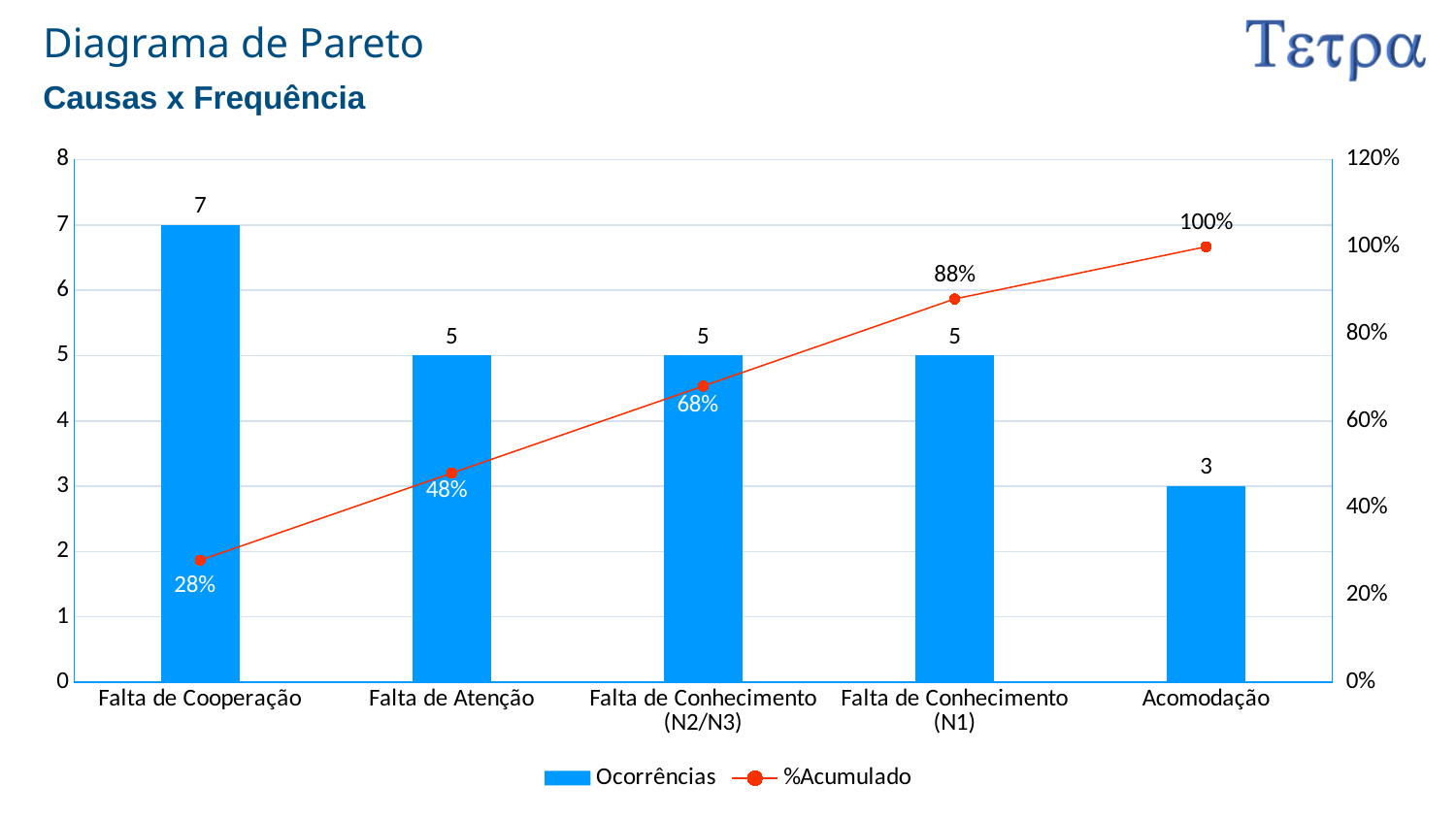
Which category has the lowest number of occurrences? Acomodação Which category has the highest number of occurrences? Falta de Cooperação How many categories are shown on the x axis? 5 How many occurrences (Ocorrências) are shown for Falta de Cooperação? 7 How many series does the legend list? 2 What is the %Acumulado value at Falta de Atenção? 48% What is the difference in occurrences between Falta de Cooperação and Acomodação? 4 Which has more occurrences, Falta de Atenção or Acomodação? Falta de Atenção What is the %Acumulado value at Falta de Conhecimento (N1)? 88% Does the %Acumulado line rise or fall from left to right? rise What is the total number of occurrences across all five categories? 25 What is the subtitle shown above the chart? Causas x Frequência